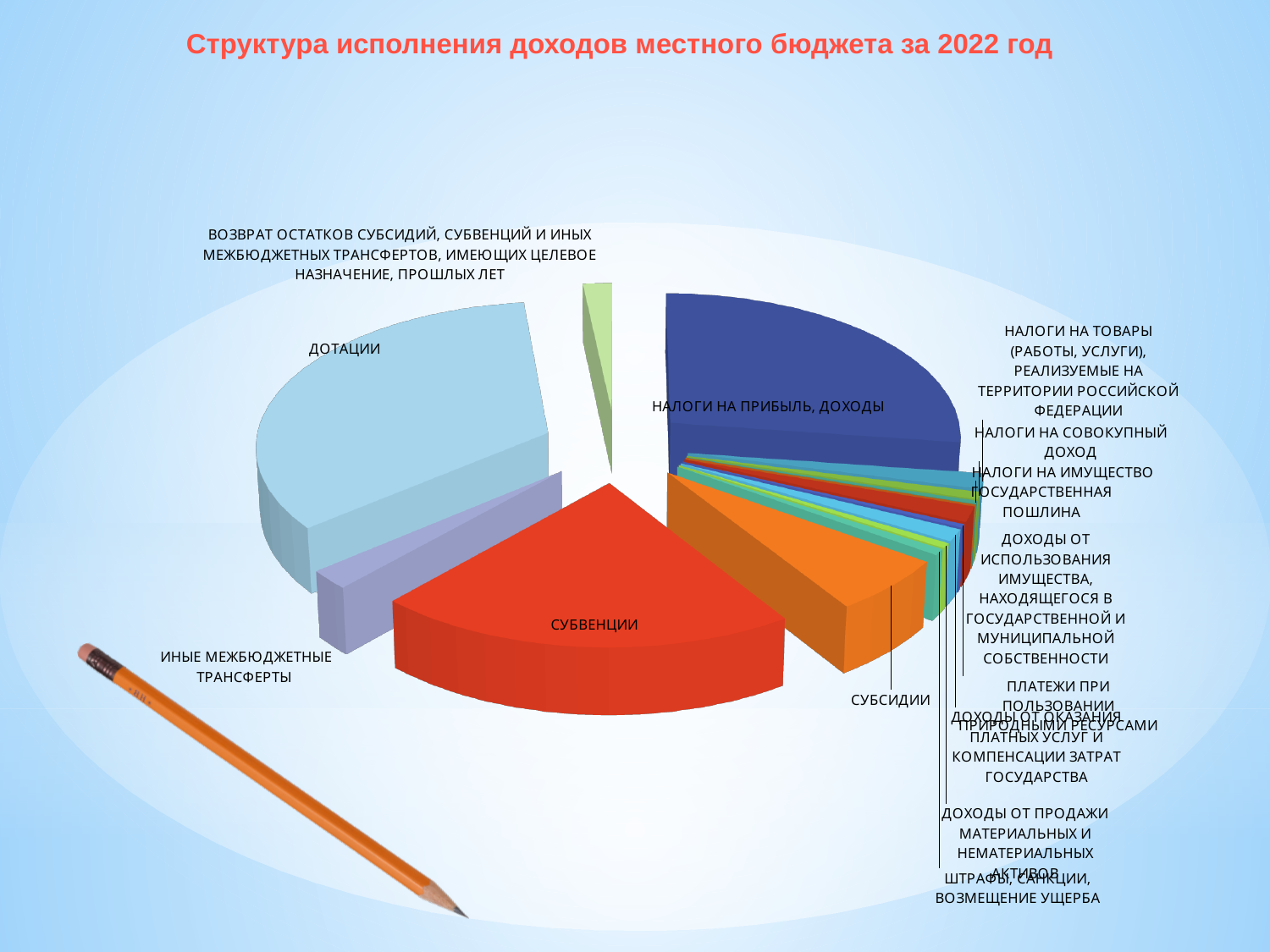
Which slice is larger, СУБСИДИИ or ВОЗВРАТ ОСТАТКОВ СУБСИДИЙ, СУБВЕНЦИЙ И ИНЫХ МЕЖБЮДЖЕТНЫХ ТРАНСФЕРТОВ, ИМЕЮЩИХ ЦЕЛЕВОЕ НАЗНАЧЕНИЕ, ПРОШЛЫХ ЛЕТ? СУБСИДИИ What is the title of the chart on the slide? Структура исполнения доходов местного бюджета за 2022 год What colour is the СУБВЕНЦИИ slice of the pie? red Which slice is larger, ДОТАЦИИ or ИНЫЕ МЕЖБЮДЖЕТНЫЕ ТРАНСФЕРТЫ? ДОТАЦИИ Which category has the largest slice of the pie? ДОТАЦИИ Which slice is larger, СУБВЕНЦИИ or СУБСИДИИ? СУБВЕНЦИИ What kind of chart is shown on the slide? pie chart